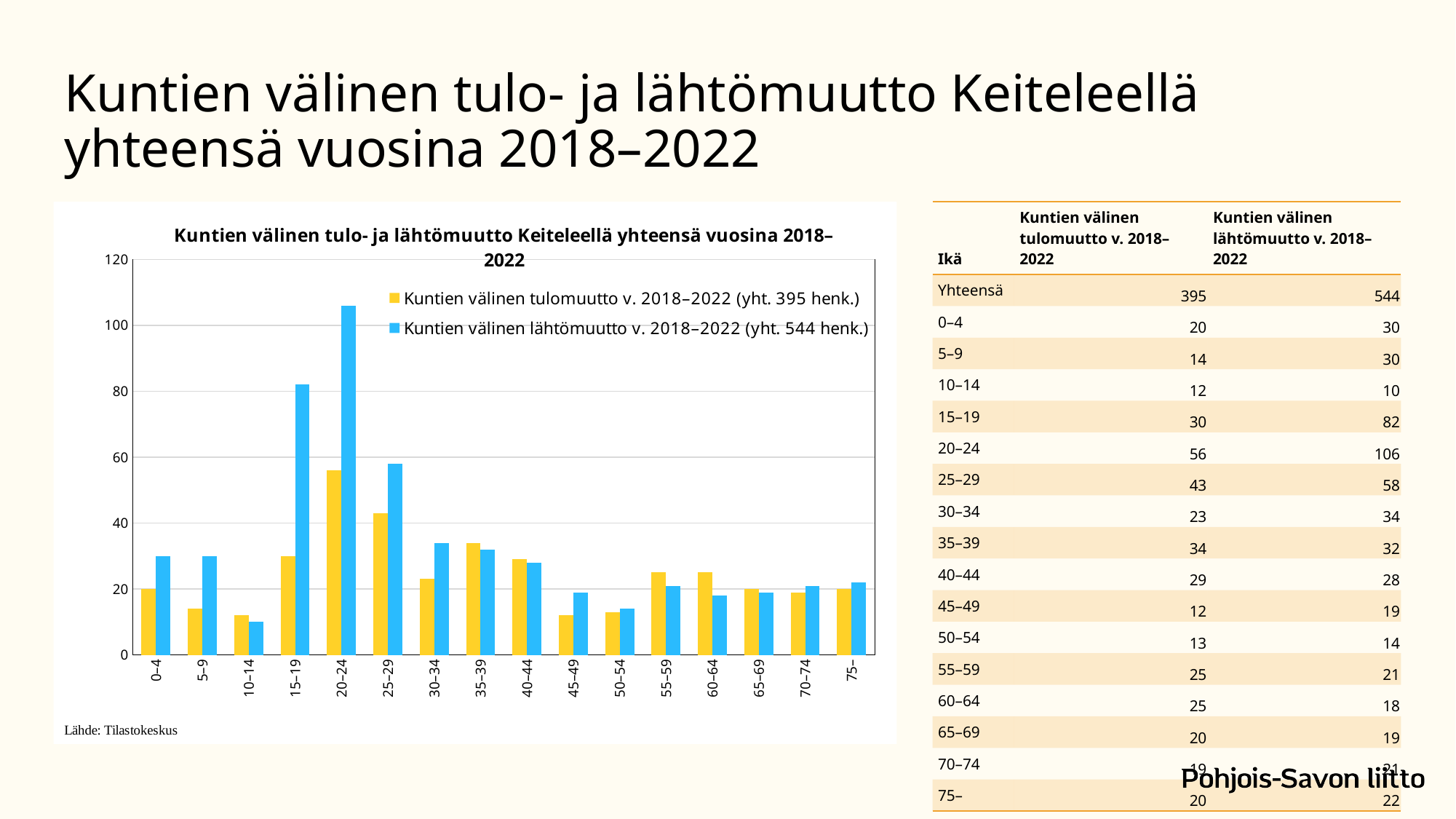
Which age group has the highest value for Kuntien välinen lähtömuutto v. 2018–2022? 20–24 What is the value of Kuntien välinen lähtömuutto v. 2018–2022 for the 15–19 age group? 82 What is the value of Kuntien välinen tulomuutto v. 2018–2022 for the 25–29 age group? 43 How many age groups are shown on the x axis of the chart? 16 How many series does the chart legend list? 2 What kind of chart is shown on the slide? bar chart What is the difference between lähtömuutto and tulomuutto for the 20–24 age group? 50 Is the value for Kuntien välinen lähtömuutto in the 20–24 age group greater or less than 100? greater Which colour represents Kuntien välinen lähtömuutto v. 2018–2022 in the chart? blue According to the legend, what is the total number of people for Kuntien välinen tulomuutto v. 2018–2022? 395 henk. For the 15–19 age group, which is larger: tulomuutto or lähtömuutto? lähtömuutto Which age group has the lowest value for Kuntien välinen lähtömuutto v. 2018–2022? 10–14